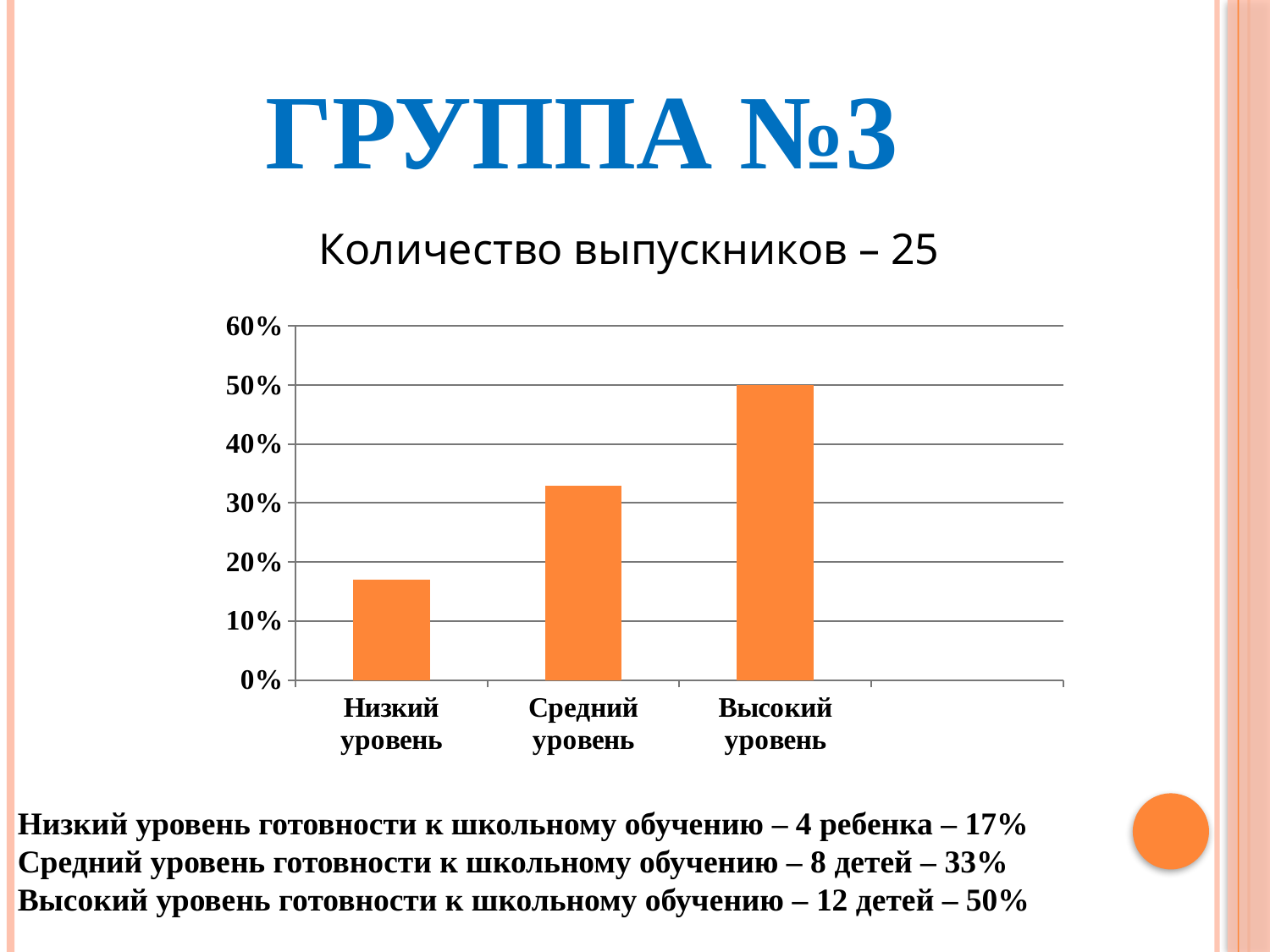
What is the difference between the values for Высокий уровень and Низкий уровень? 33% What is the value for Высокий уровень? 50% Is the value for Средний уровень greater or less than 30%? greater Which is larger, the value for Средний уровень or the value for Низкий уровень? Средний уровень What is the value for Низкий уровень? 17% Which category has the lowest bar? Низкий уровень Do the values rise or fall from left to right along the x axis? rise Which category has the highest bar? Высокий уровень How many categories are plotted on the chart? 3 Is the value for Низкий уровень greater or less than 20%? less What kind of chart is shown on the slide? bar chart What is the value for Средний уровень? 33%